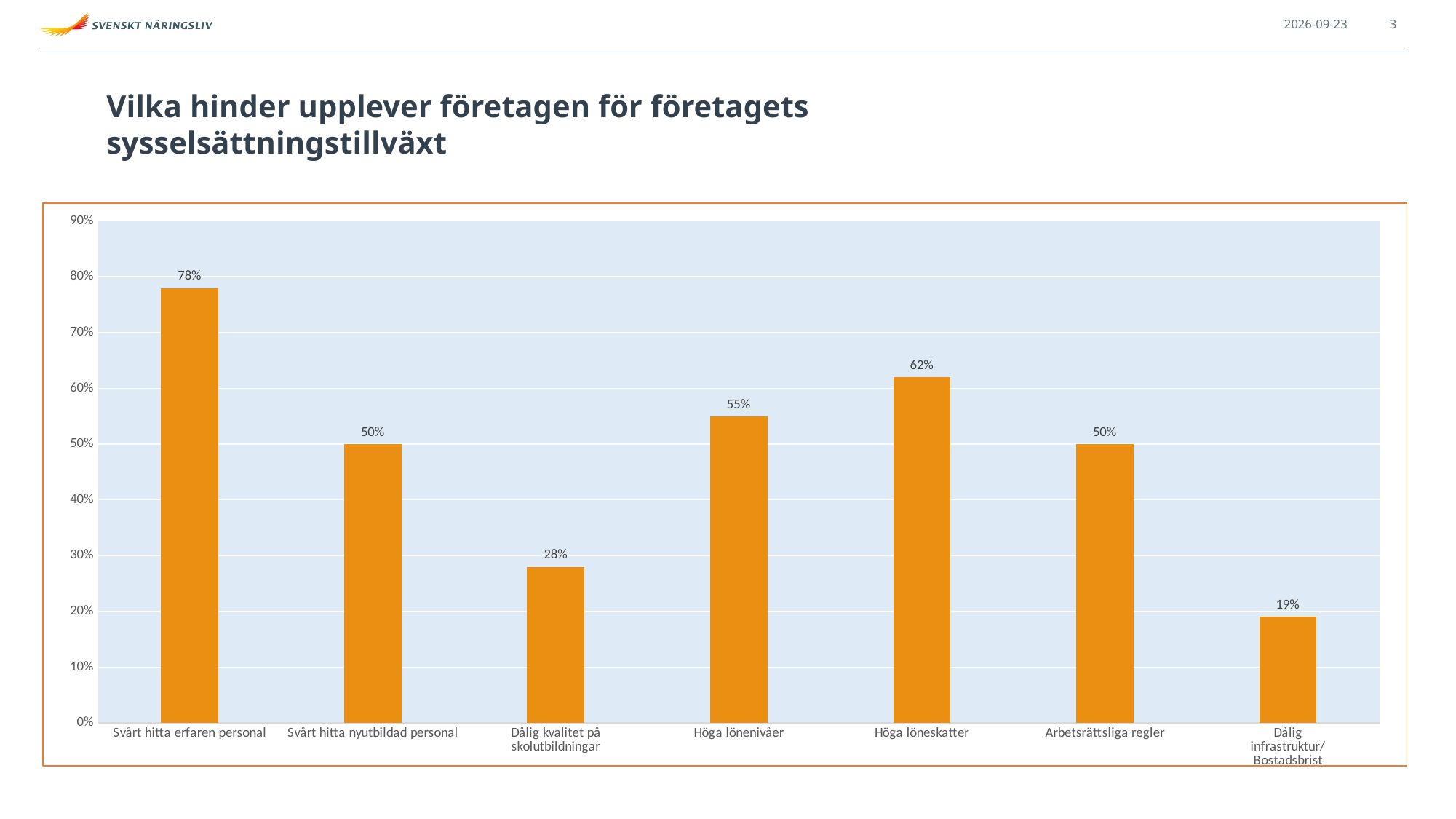
Which is larger, Höga lönenivåer or Arbetsrättsliga regler? Höga lönenivåer Which category has the highest value? Svårt hitta erfaren personal Is the value for Höga lönenivåer greater or less than 50%? greater What is the value for Höga löneskatter? 62% Which category has the lowest value? Dålig infrastruktur/Bostadsbrist What is the value for Dålig infrastruktur/Bostadsbrist? 19% What is the value for Svårt hitta erfaren personal? 78% What is the difference between Svårt hitta erfaren personal and Höga löneskatter? 16% What is the title of the slide? Vilka hinder upplever företagen för företagets sysselsättningstillväxt What is the value for Dålig kvalitet på skolutbildningar? 28% How many categories are shown in the chart? 7 What kind of chart is shown on the slide? Bar chart